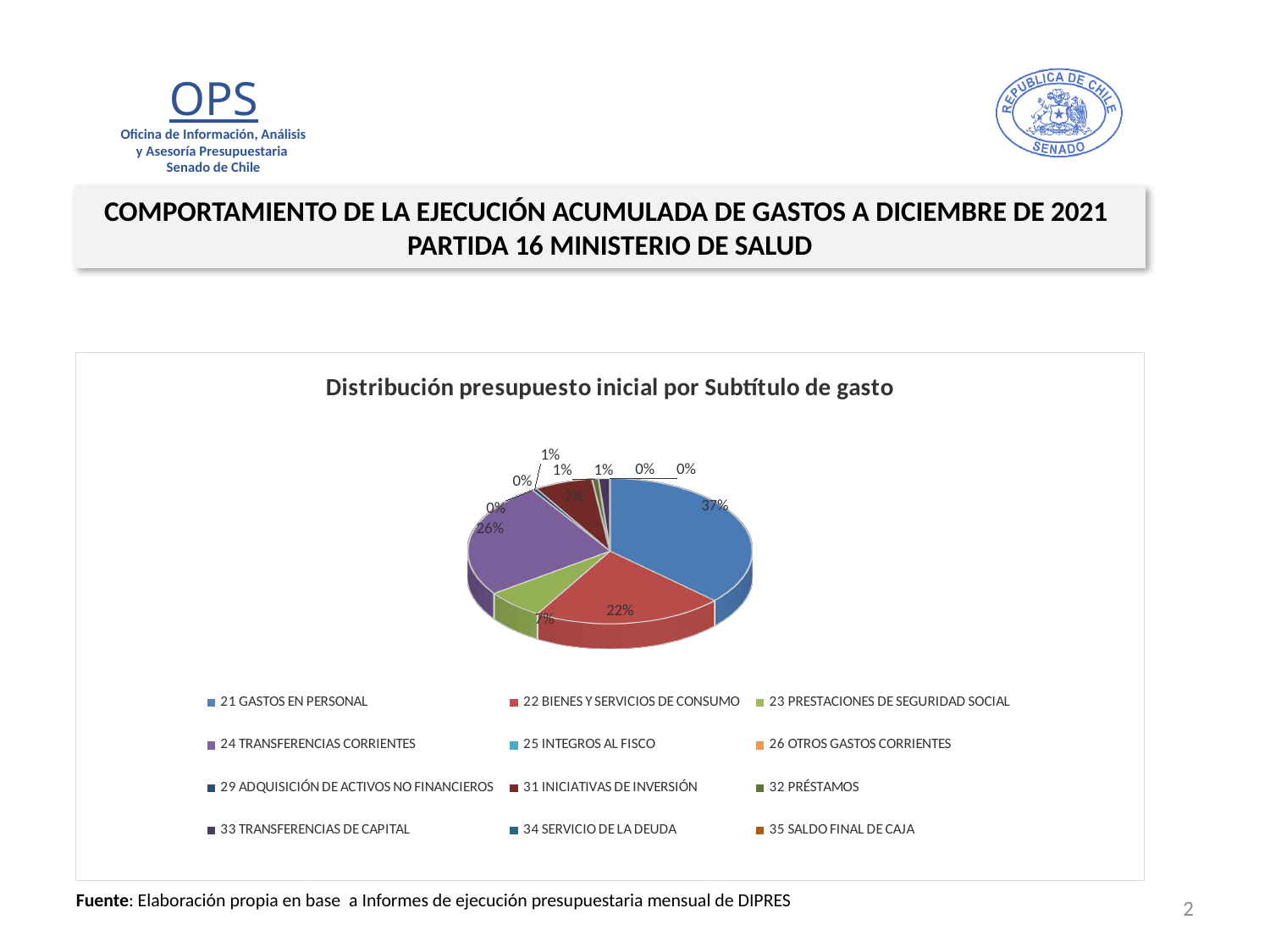
What share of the pie does 31 INICIATIVAS DE INVERSIÓN represent? 7% What is the difference in percentage points between the share of 22 BIENES Y SERVICIOS DE CONSUMO and 23 PRESTACIONES DE SEGURIDAD SOCIAL? 15 percentage points What kind of chart is shown on the slide? Pie chart How many categories does the legend list? 12 What share of the pie does 23 PRESTACIONES DE SEGURIDAD SOCIAL represent? 7% What is the title of the chart? Distribución presupuesto inicial por Subtítulo de gasto Which has a larger share: 22 BIENES Y SERVICIOS DE CONSUMO or 24 TRANSFERENCIAS CORRIENTES? 24 TRANSFERENCIAS CORRIENTES Which category has the largest share of the pie? 21 GASTOS EN PERSONAL What is the difference in percentage points between the share of 21 GASTOS EN PERSONAL and 24 TRANSFERENCIAS CORRIENTES? 11 percentage points What share of the pie does 24 TRANSFERENCIAS CORRIENTES represent? 26%